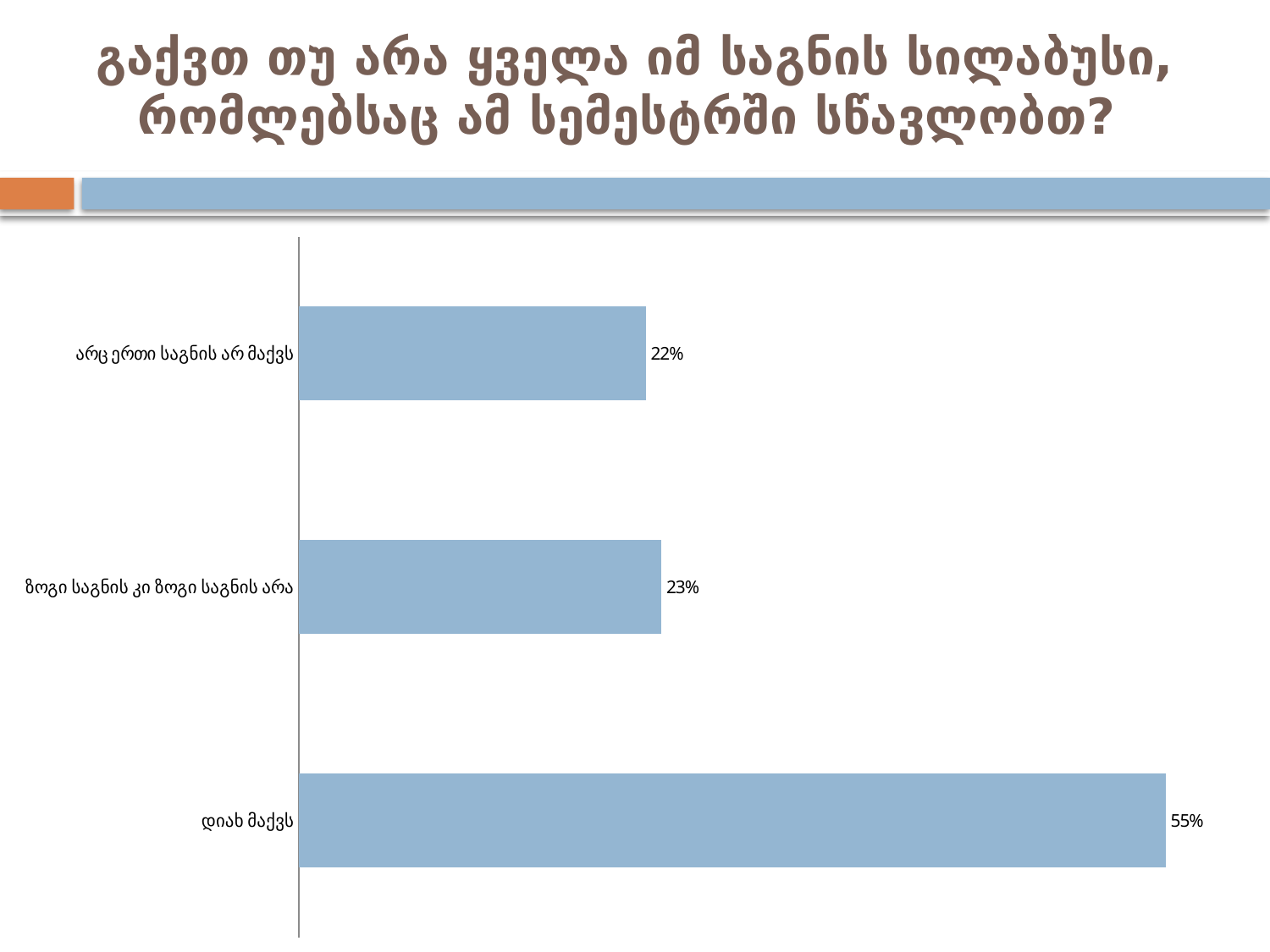
What kind of chart is shown on the slide? Bar chart Which is larger: the value for "დიახ მაქვს" or the value for "არც ერთი საგნის არ მაქვს"? დიახ მაქვს How many categories are shown in the chart? 3 What value is shown for "დიახ მაქვს"? 55% What value is shown for "ზოგი საგნის კი ზოგი საგნის არა"? 23% What is the total of the three values shown in the chart? 100% Which category has the lowest value? არც ერთი საგნის არ მაქვს Which category has the highest value? დიახ მაქვს What value is shown for "არც ერთი საგნის არ მაქვს"? 22% What is the difference between the values for "ზოგი საგნის კი ზოგი საგნის არა" and "არც ერთი საგნის არ მაქვს"? 1% What is the difference between the values for "დიახ მაქვს" and "ზოგი საგნის კი ზოგი საგნის არა"? 32% What colour are the bars in the chart? Light blue